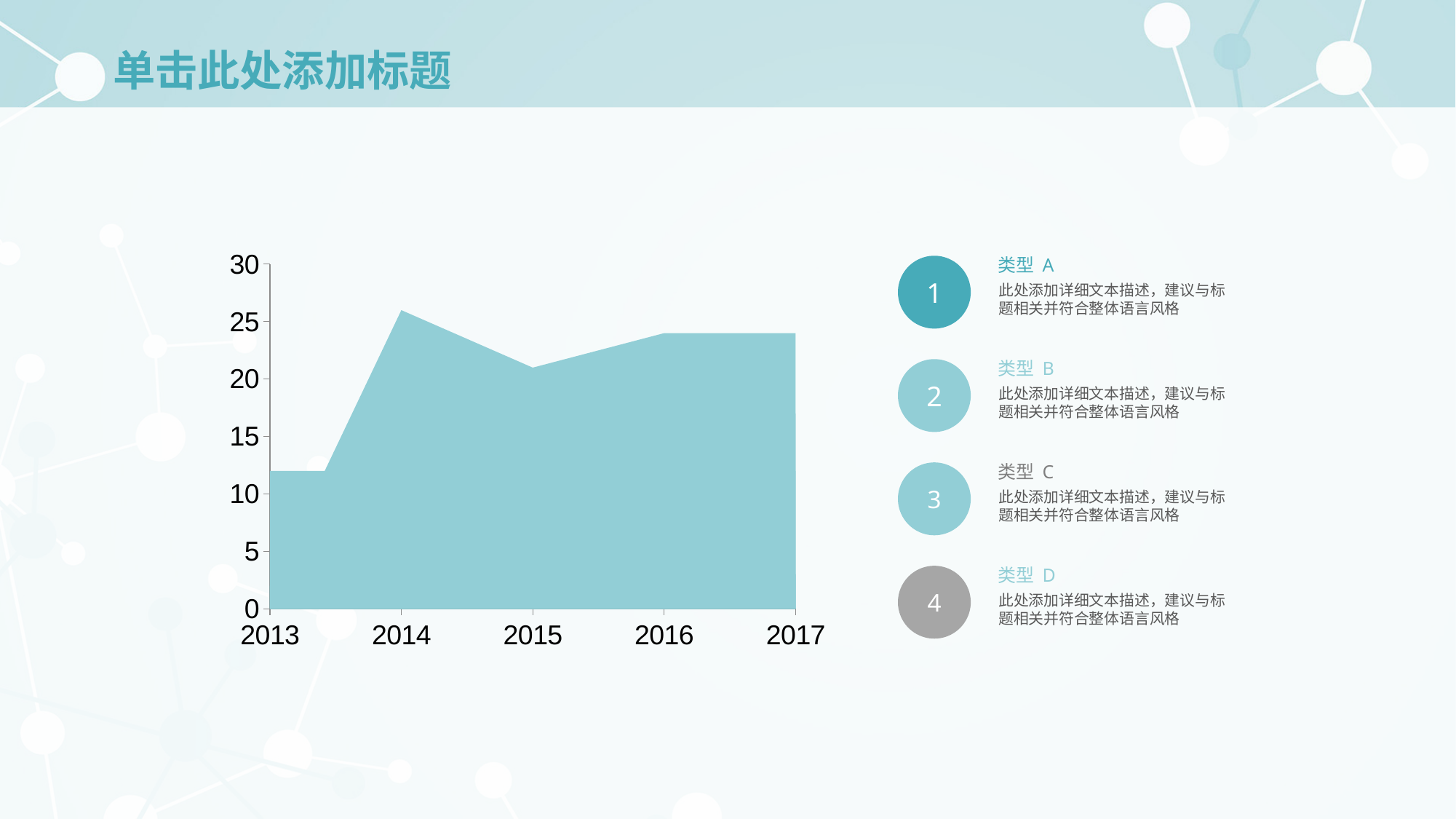
Which year has the lowest value in the chart? 2013 Is the value for 2015 greater or less than 20? greater Is the value for 2014 greater or less than 25? greater Which is larger, the value for 2014 or the value for 2015? 2014 Is the value for 2013 greater or less than 15? less Which year has the highest value in the chart? 2014 Does the value rise or fall from 2014 to 2015? fall What kind of chart is shown on the slide? area chart Does the value rise or fall from 2013 to 2014? rise How many years are shown on the x axis of the chart? 5